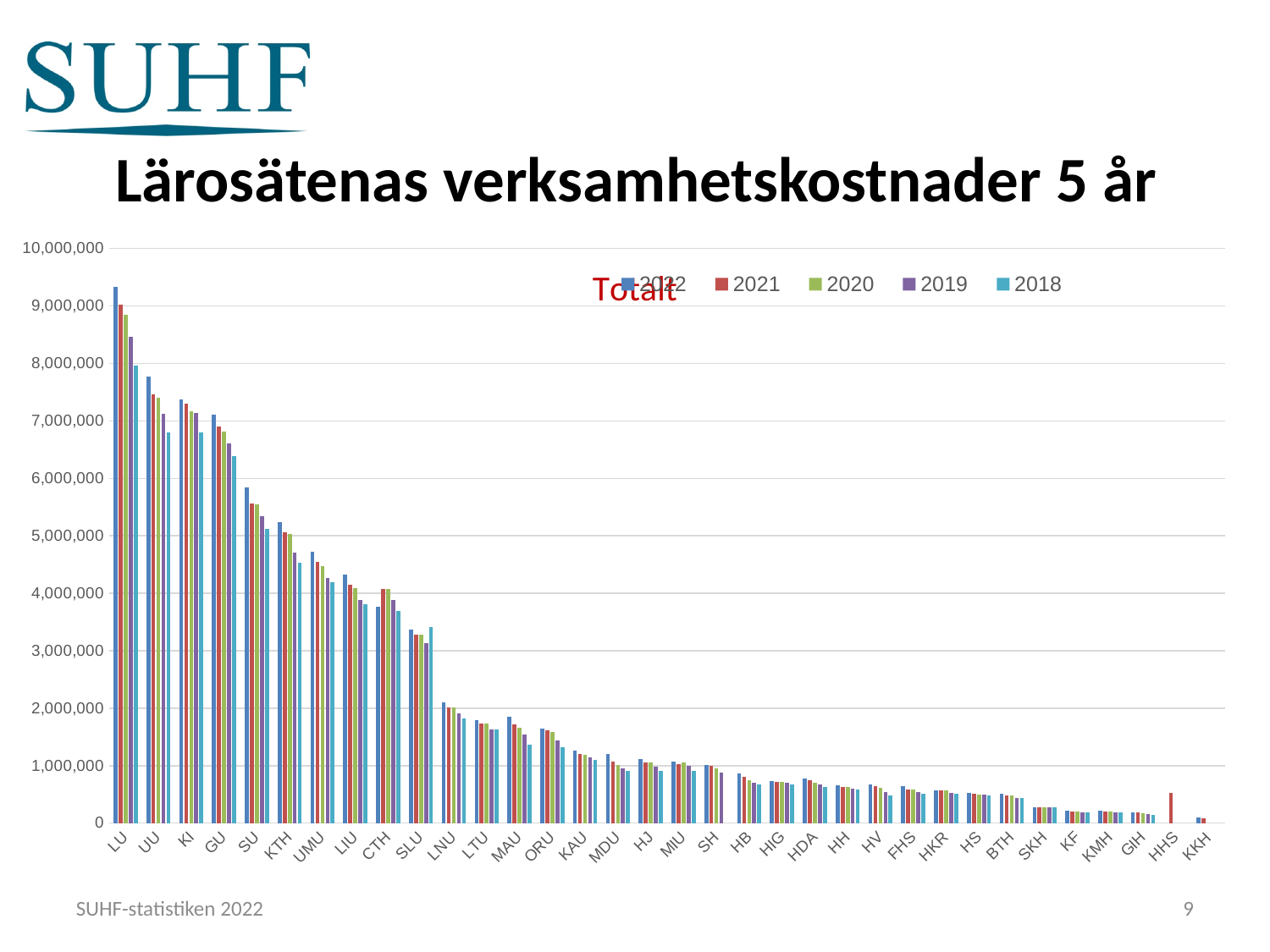
Is the 2022 value for LU greater or less than 9,000,000? greater Which category has the highest value for 2022? LU What kind of chart is shown on the slide? bar chart How many series does the legend list? 5 Is the 2022 value for SU greater or less than 6,000,000? less What is the title of the chart? Lärosätenas verksamhetskostnader 5 år Is the 2022 value for CTH greater or less than 4,000,000? less Do the 2022 values generally rise or fall from left to right along the x axis? fall Which has the larger 2022 value, LU or UU? LU Which has the larger 2022 value, KTH or LNU? KTH